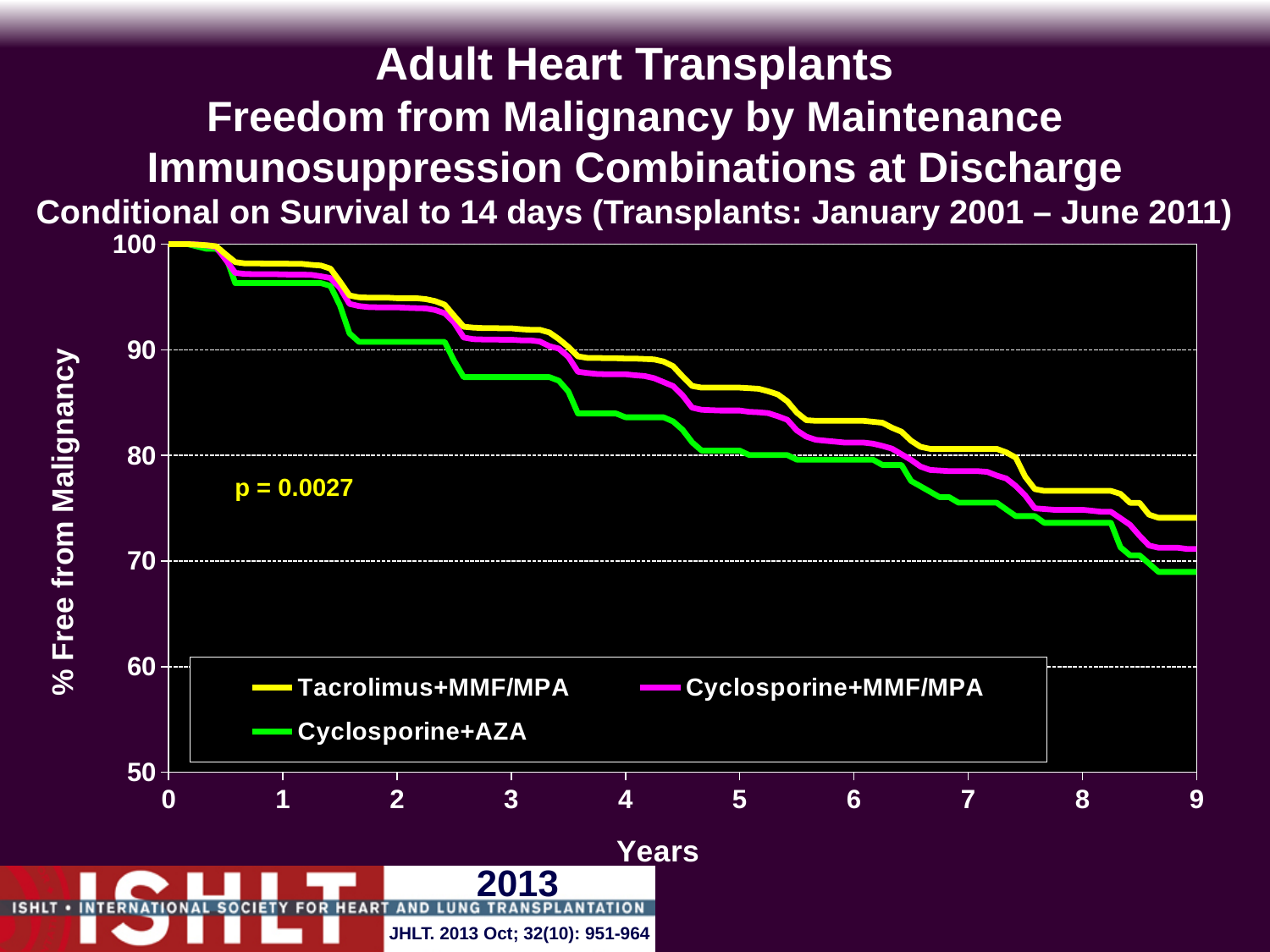
At year 4, which is higher: Tacrolimus+MMF/MPA or Cyclosporine+AZA? Tacrolimus+MMF/MPA Is the value for Cyclosporine+AZA at year 3 greater or less than 90? less Is the value for Cyclosporine+AZA at year 9 greater or less than 70? less Which series has the lowest % free from malignancy at year 9? Cyclosporine+AZA Is the value for Tacrolimus+MMF/MPA at year 9 greater or less than 70? greater What p-value is printed on the chart? p = 0.0027 How many series does the legend list? 3 What kind of chart is shown on the slide? Line chart Do the values for Cyclosporine+AZA rise or fall as years increase? Fall Which series is shown in yellow? Tacrolimus+MMF/MPA Which series has the highest % free from malignancy at year 9? Tacrolimus+MMF/MPA